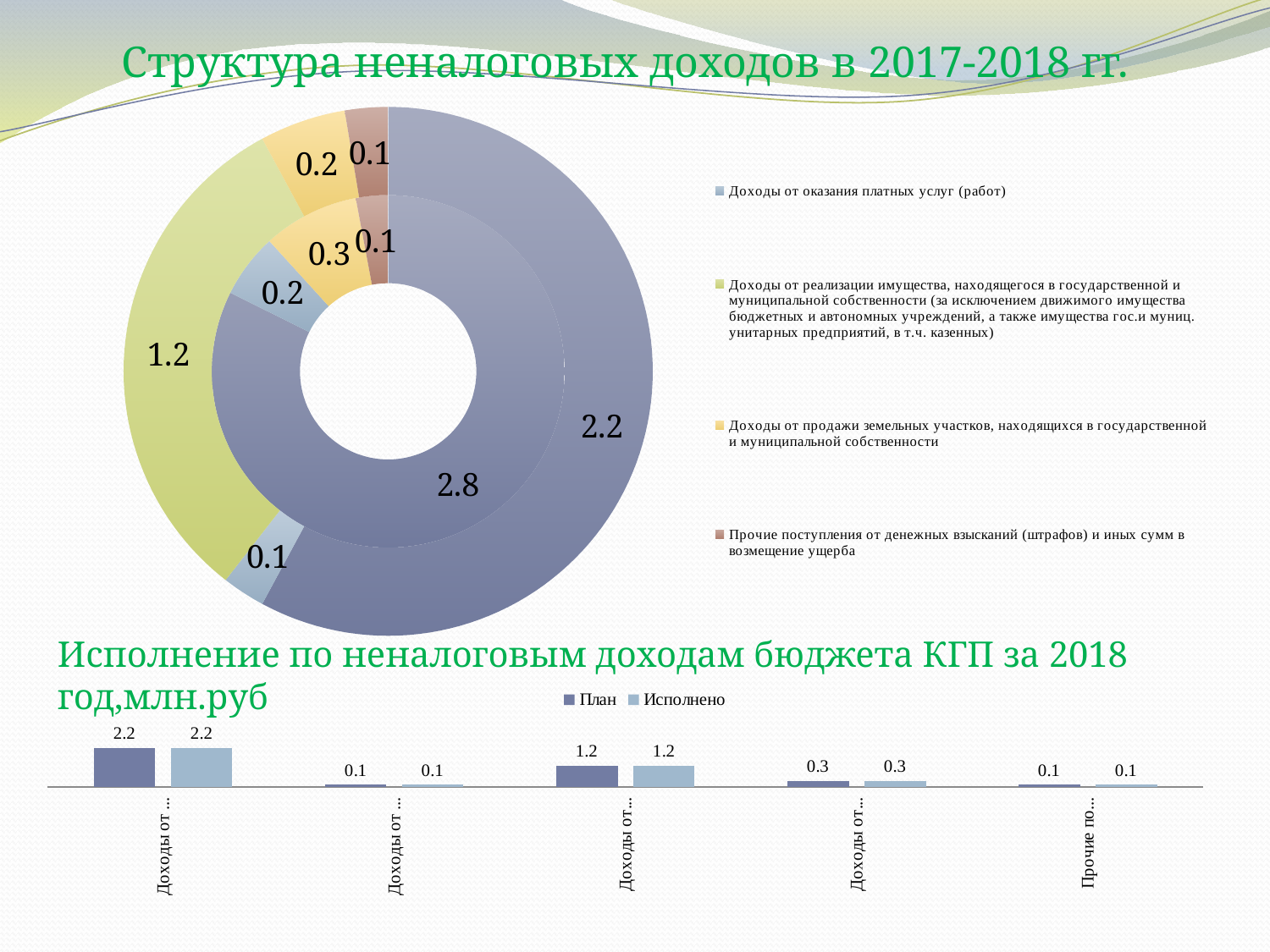
In the bottom bar chart, what is the 'План' value for the fourth category? 0.3 In the top doughnut chart, what is the value of the largest slice in the inner ring? 2.8 In the bottom bar chart, what is the difference between the 'План' value of the first category and the 'План' value of the fourth category? 1.9 In the top doughnut chart, how many entries does the legend list? 4 What kind of chart is the top chart titled 'Структура неналоговых доходов в 2017-2018 гг.'? doughnut chart In the bottom bar chart, what is the 'План' value for the first (leftmost) category? 2.2 In the bottom bar chart, what is the 'Исполнено' value for the third category? 1.2 In the bottom bar chart, how many categories are shown on the x axis? 5 In the bottom bar chart, which category has the highest 'План' value? the first (leftmost) category In the bottom bar chart, how many series does the legend list? 2 What kind of chart is the bottom chart titled 'Исполнение по неналоговым доходам бюджета КГП за 2018 год,млн.руб'? bar chart In the bottom bar chart, which is larger: the 'Исполнено' value for the third category or the 'Исполнено' value for the fourth category? the third category